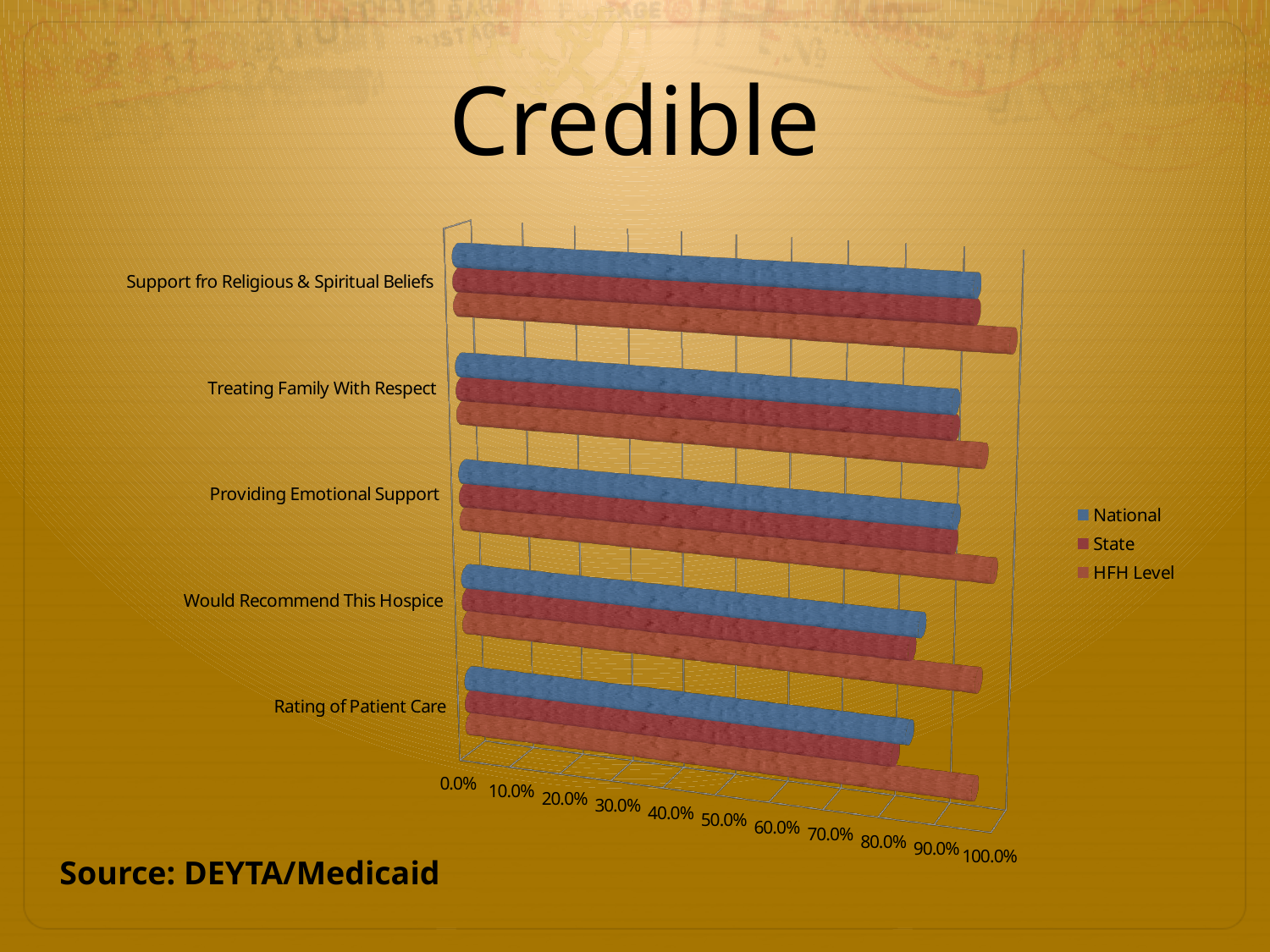
For Support fro Religious & Spiritual Beliefs, which is larger: the National value or the HFH Level value? HFH Level Is the State value for Would Recommend This Hospice greater or less than 60.0%? greater What is the title of the slide containing the chart? Credible How many series does the legend list? 3 For Would Recommend This Hospice, which is larger: the State value or the HFH Level value? HFH Level Which category has the highest HFH Level value? Support fro Religious & Spiritual Beliefs Is the National value for Rating of Patient Care greater or less than 50.0%? greater What kind of chart is shown on the slide? Bar chart What is the maximum value shown on the percentage axis? 100.0% Is the HFH Level value for Support fro Religious & Spiritual Beliefs greater or less than 80.0%? greater How many categories are plotted on the chart? 5 What are the series names listed in the legend? National, State, HFH Level